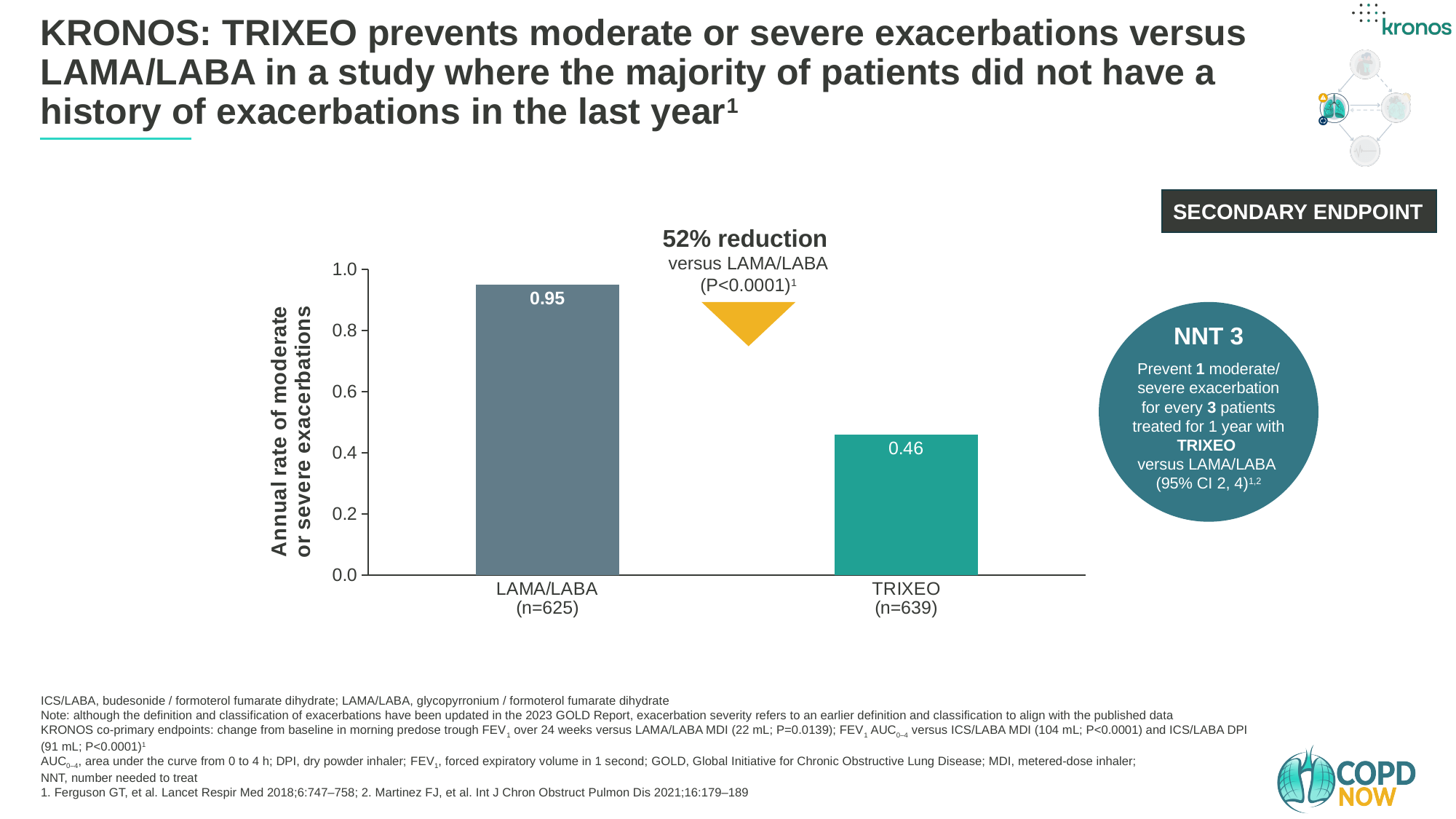
What type of chart is used to show the annual exacerbation rates? Bar chart Is the annual exacerbation rate for LAMA/LABA greater or less than 0.8? greater Which treatment group has the lower annual rate of moderate or severe exacerbations? TRIXEO Is the annual exacerbation rate for TRIXEO greater or less than 0.6? less Which treatment group has the higher annual rate of moderate or severe exacerbations? LAMA/LABA What is the difference in annual exacerbation rate between LAMA/LABA and TRIXEO? 0.49 How many patients were in the TRIXEO group according to the x-axis label? n=639 What is the label of the y-axis? Annual rate of moderate or severe exacerbations What is the percentage reduction in exacerbations with TRIXEO versus LAMA/LABA shown above the chart? 52% reduction What is the annual rate of moderate or severe exacerbations for LAMA/LABA? 0.95 What is the annual rate of moderate or severe exacerbations for TRIXEO? 0.46 How many treatment groups are shown in the chart? 2